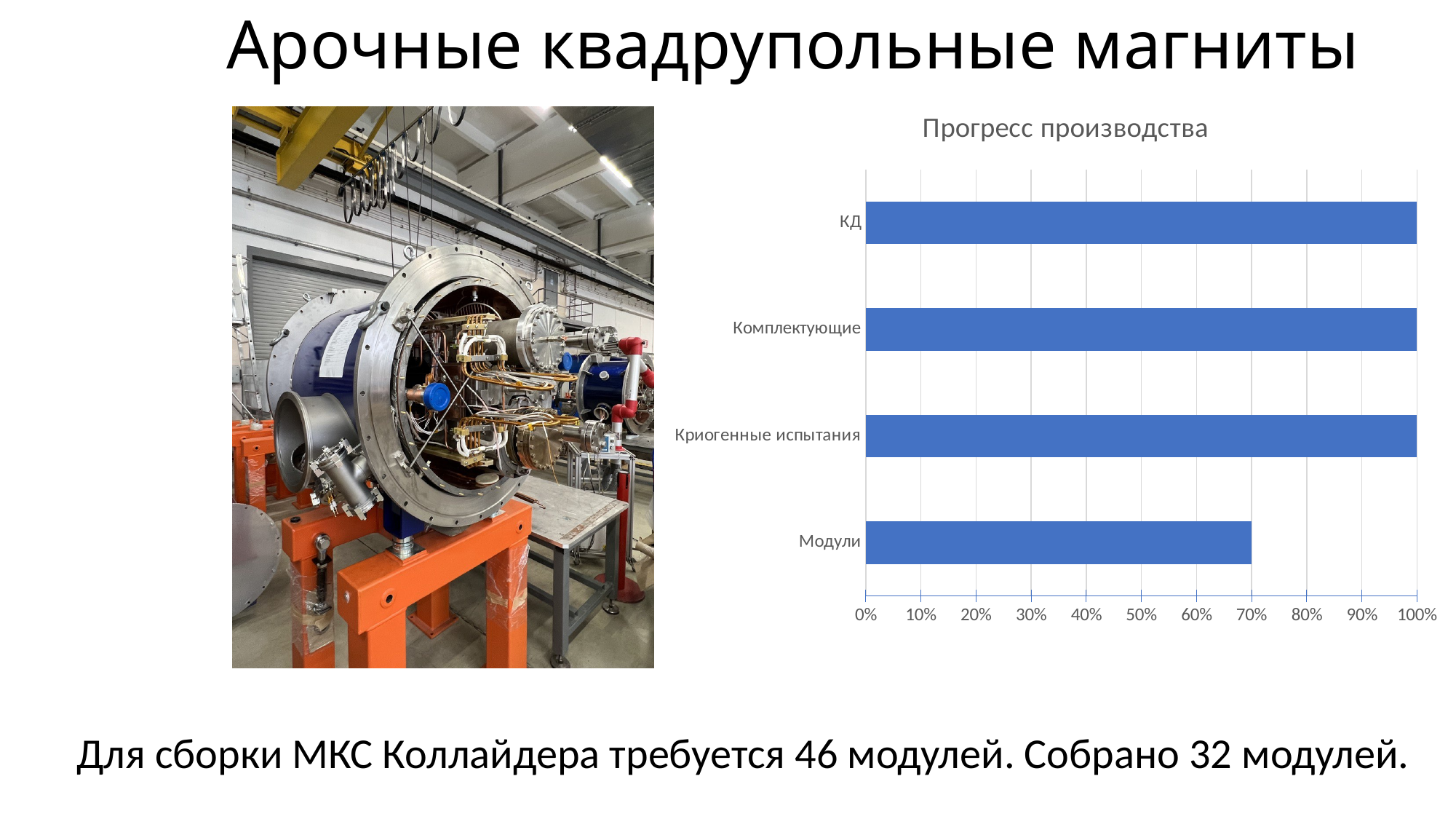
What is the title of the chart on the slide? Прогресс производства Is the value for Модули greater or less than 60%? greater What colour are the bars in the "Прогресс производства" chart? blue What is the value for Комплектующие in the "Прогресс производства" chart? 100% How many categories in the "Прогресс производства" chart reach 100%? 3 Which category has the lowest value in the "Прогресс производства" chart? Модули Is the value for Модули greater or less than 80%? less What kind of chart is shown under the title "Прогресс производства"? bar chart How many categories are plotted in the "Прогресс производства" chart? 4 Which is larger in the "Прогресс производства" chart, the value for КД or the value for Модули? КД What is the value for Криогенные испытания in the "Прогресс производства" chart? 100% What is the value for КД in the "Прогресс производства" chart? 100%